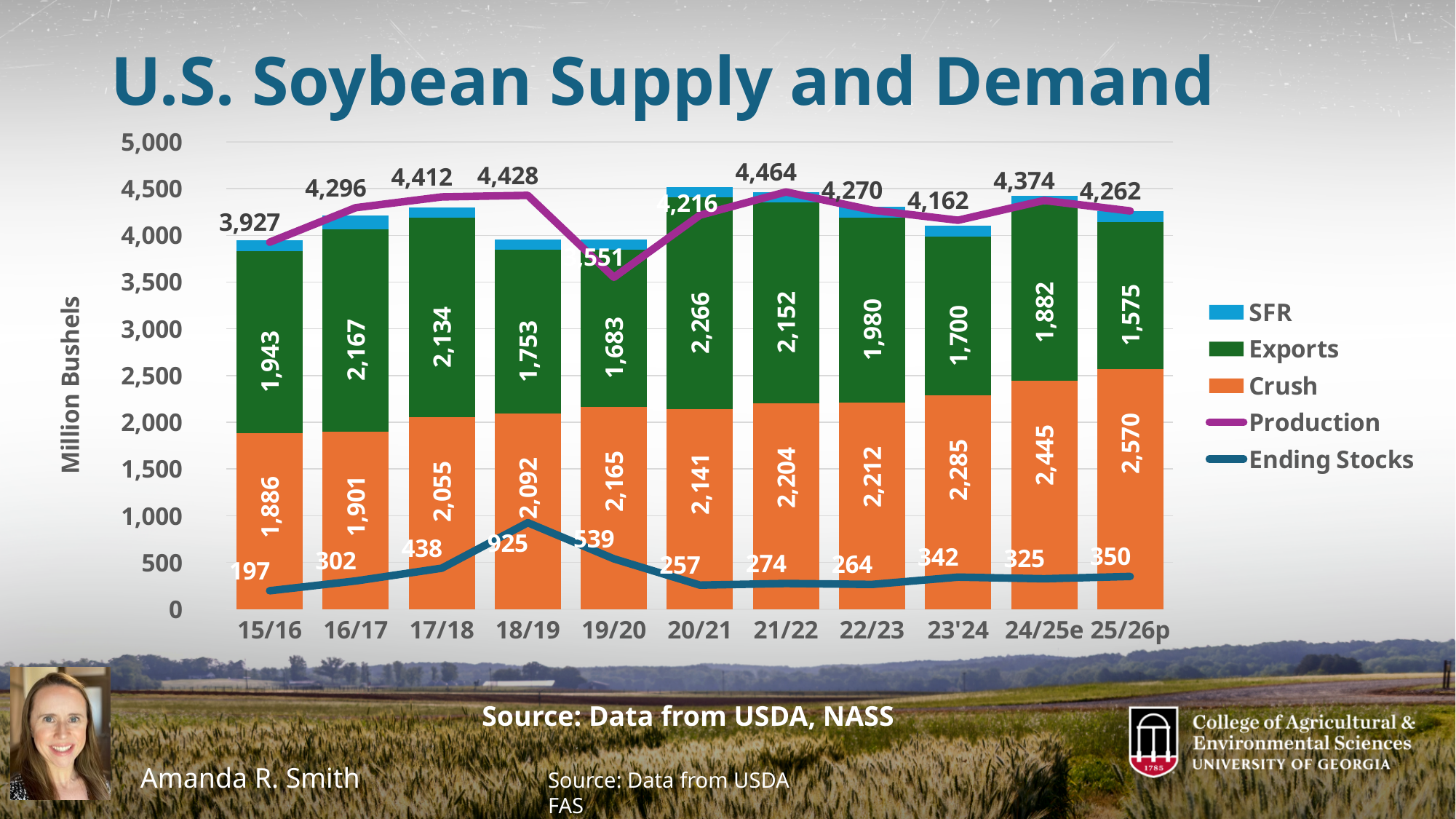
What is the difference between the Crush value for 25/26p and the Crush value for 15/16? 684 What is the Production value for 19/20? 3,551 In which year is Production highest? 21/22 In which year is Production lowest? 19/20 What is the Ending Stocks value for 18/19? 925 Does the Crush value generally rise or fall from 15/16 to 25/26p? rise What is the Crush value for 25/26p? 2,570 How many series does the legend list? 5 What is the Exports value for 20/21? 2,266 How many marketing years are shown on the x axis? 11 Which is larger, Exports in 16/17 or Exports in 17/18? 16/17 In which year are Exports lowest? 25/26p